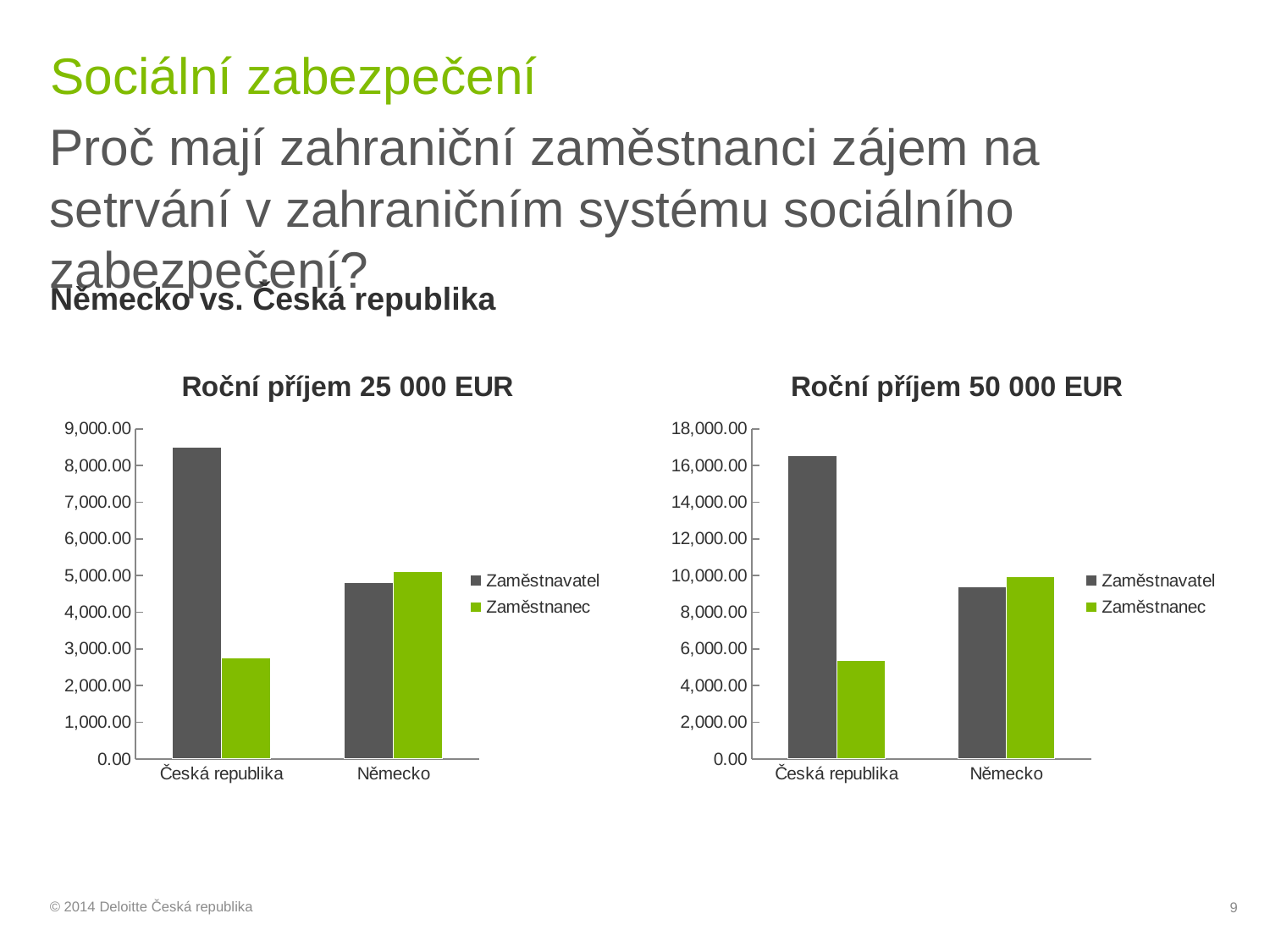
In the chart titled "Roční příjem 25 000 EUR", what kind of chart is shown? bar chart In the chart titled "Roční příjem 50 000 EUR", which is larger for Česká republika: the Zaměstnavatel value or the Zaměstnanec value? Zaměstnavatel In the chart titled "Roční příjem 50 000 EUR", is the Zaměstnavatel value for Česká republika greater or less than 16,000.00? greater In the chart titled "Roční příjem 25 000 EUR", which category has the highest Zaměstnavatel value? Česká republika In the chart titled "Roční příjem 25 000 EUR", how many categories are shown on the x axis? 2 In the chart titled "Roční příjem 50 000 EUR", which colour represents the Zaměstnanec series? green In the chart titled "Roční příjem 25 000 EUR", which category has the lowest Zaměstnanec value? Česká republika In the chart titled "Roční příjem 25 000 EUR", is the Zaměstnanec value for Česká republika greater or less than 3,000.00? less In the chart titled "Roční příjem 50 000 EUR", which is larger for Německo: the Zaměstnavatel value or the Zaměstnanec value? Zaměstnanec In the chart titled "Roční příjem 25 000 EUR", is the Zaměstnavatel value for Česká republika greater or less than 8,000.00? greater In the chart titled "Roční příjem 25 000 EUR", how many series does the legend list? 2